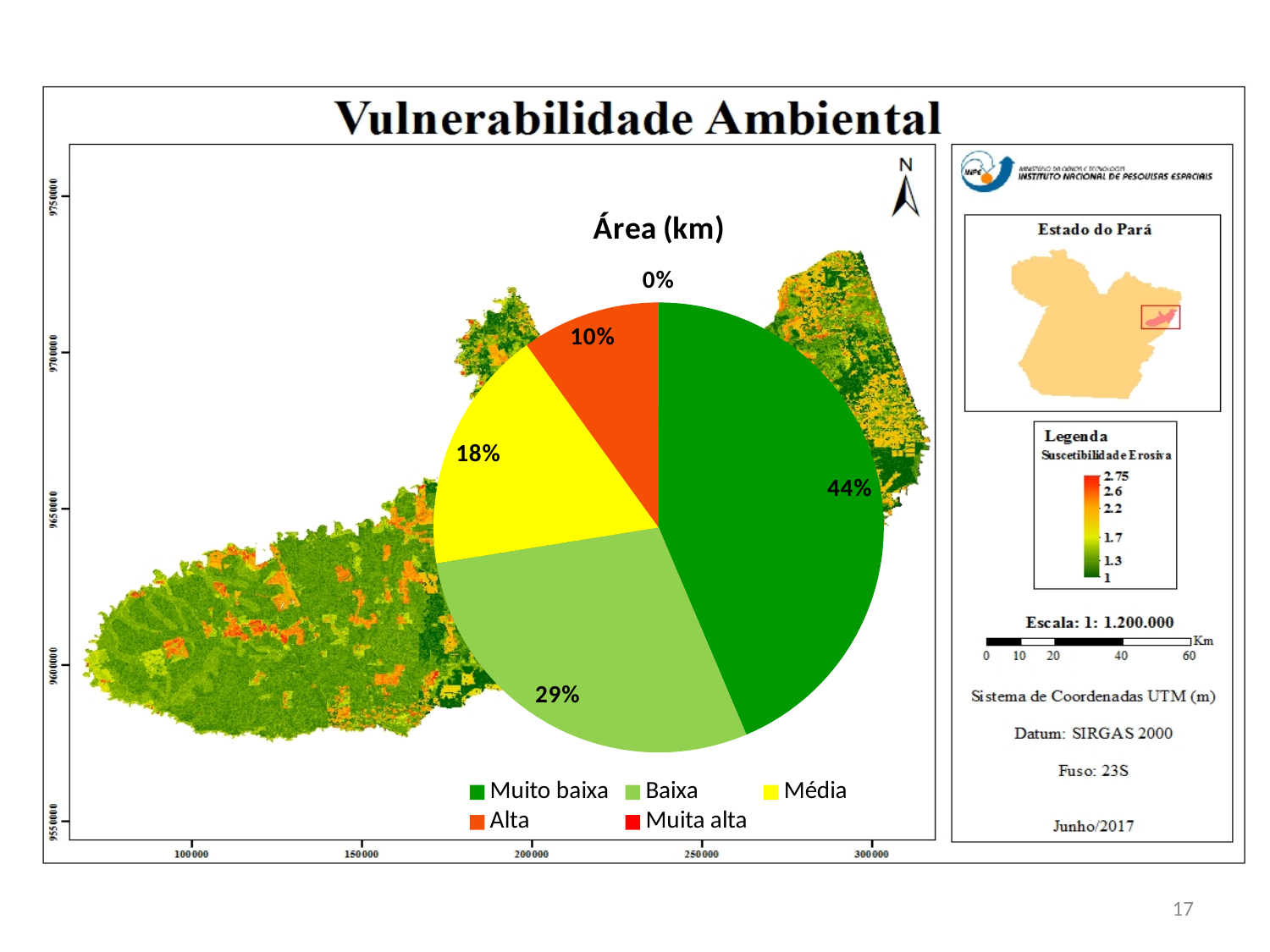
Which category has the largest share of the pie? Muito baixa What share of the pie does the 'Alta' slice represent? 10% What is the difference in percentage points between the 'Muito baixa' and 'Baixa' slices? 15% What kind of chart is shown on the slide? pie chart How many categories does the pie chart legend list? 5 Which slice is larger, 'Média' or 'Alta'? Média What share of the pie does the 'Média' slice represent? 18% What share of the pie does the 'Muito baixa' slice represent? 44% What is the title of the pie chart? Área (km) Which category has the smallest share of the pie? Muita alta